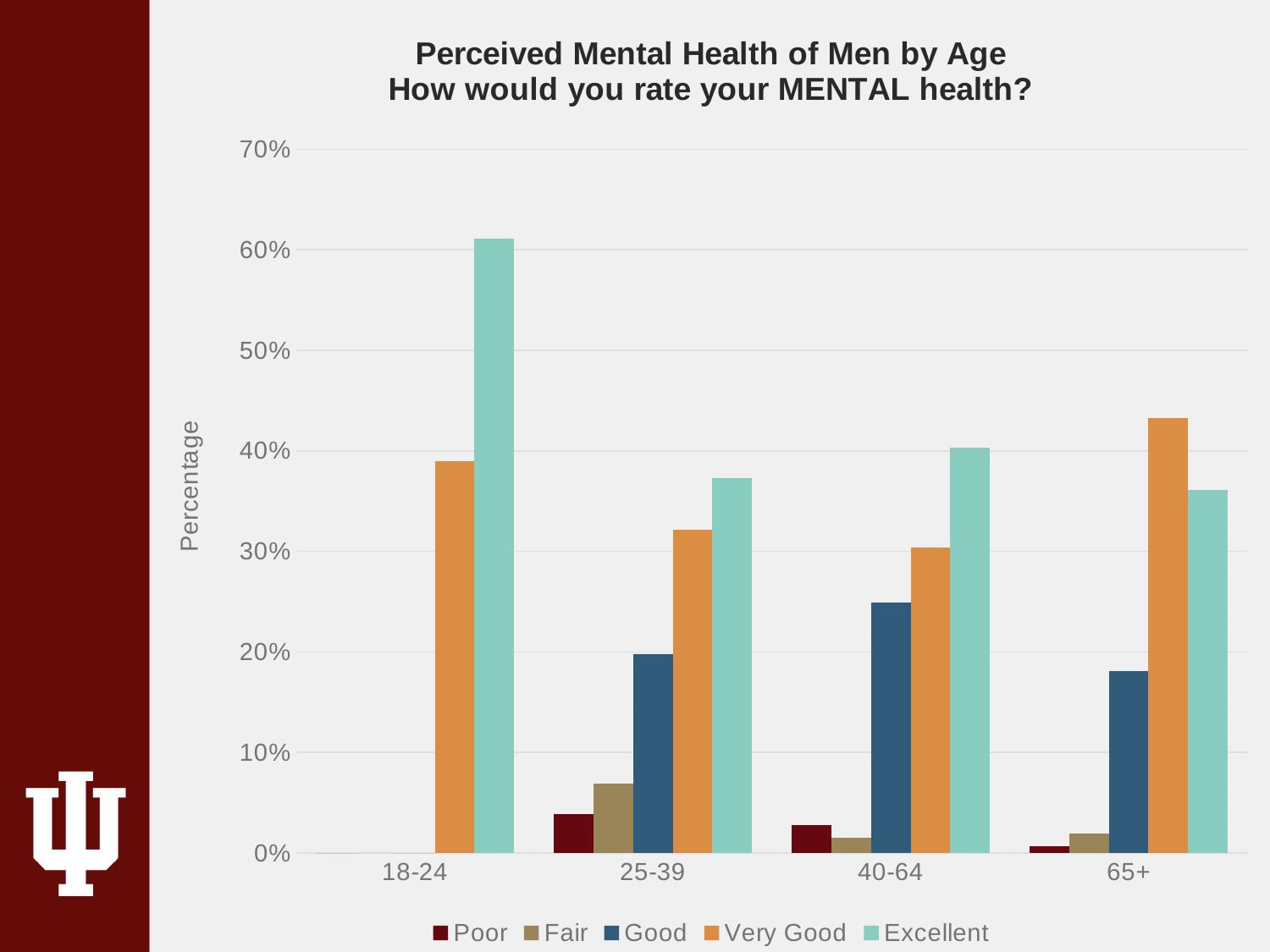
Which age group has the highest Excellent value? 18-24 For the 40-64 age group, which is larger: Good or Very Good? Very Good Is the Good value for the 25-39 age group greater or less than 10%? greater How many age groups are shown on the x axis? 4 Is the Excellent value for the 18-24 age group greater or less than 50%? greater What kind of chart is shown on the slide? Bar chart What is the label on the y axis? Percentage For the 65+ age group, which is larger: Very Good or Excellent? Very Good Which series has the highest value for the 40-64 age group? Excellent Does the Excellent value rise or fall from the 18-24 group to the 25-39 group? fall Is the Very Good value for the 65+ age group greater or less than 40%? greater How many series does the legend list? 5